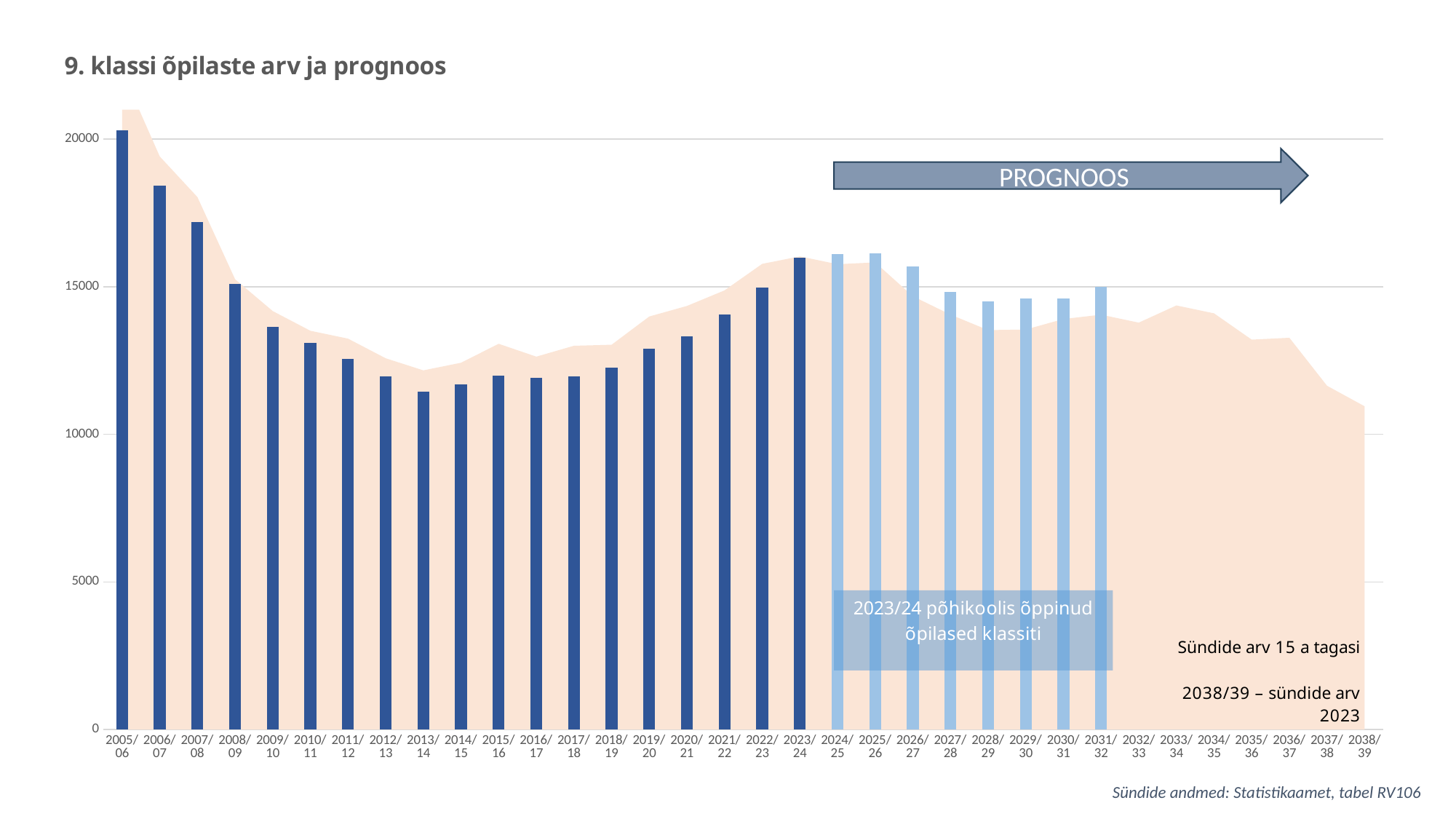
Which school year has the highest bar? 2005/06 Is the value for 2005/06 greater or less than 20000? greater What word is written on the arrow above the forecast bars? PROGNOOS What is the title of the chart? 9. klassi õpilaste arv ja prognoos Which school year has the lowest bar? 2013/14 Do the bar values rise or fall from 2005/06 to 2013/14? fall Which is larger, the value for 2007/08 or the value for 2022/23? 2007/08 Is the value for 2023/24 greater or less than 15000? greater Is the value for 2013/14 greater or less than 10000? greater What kind of chart is shown on the slide? combination bar and area chart